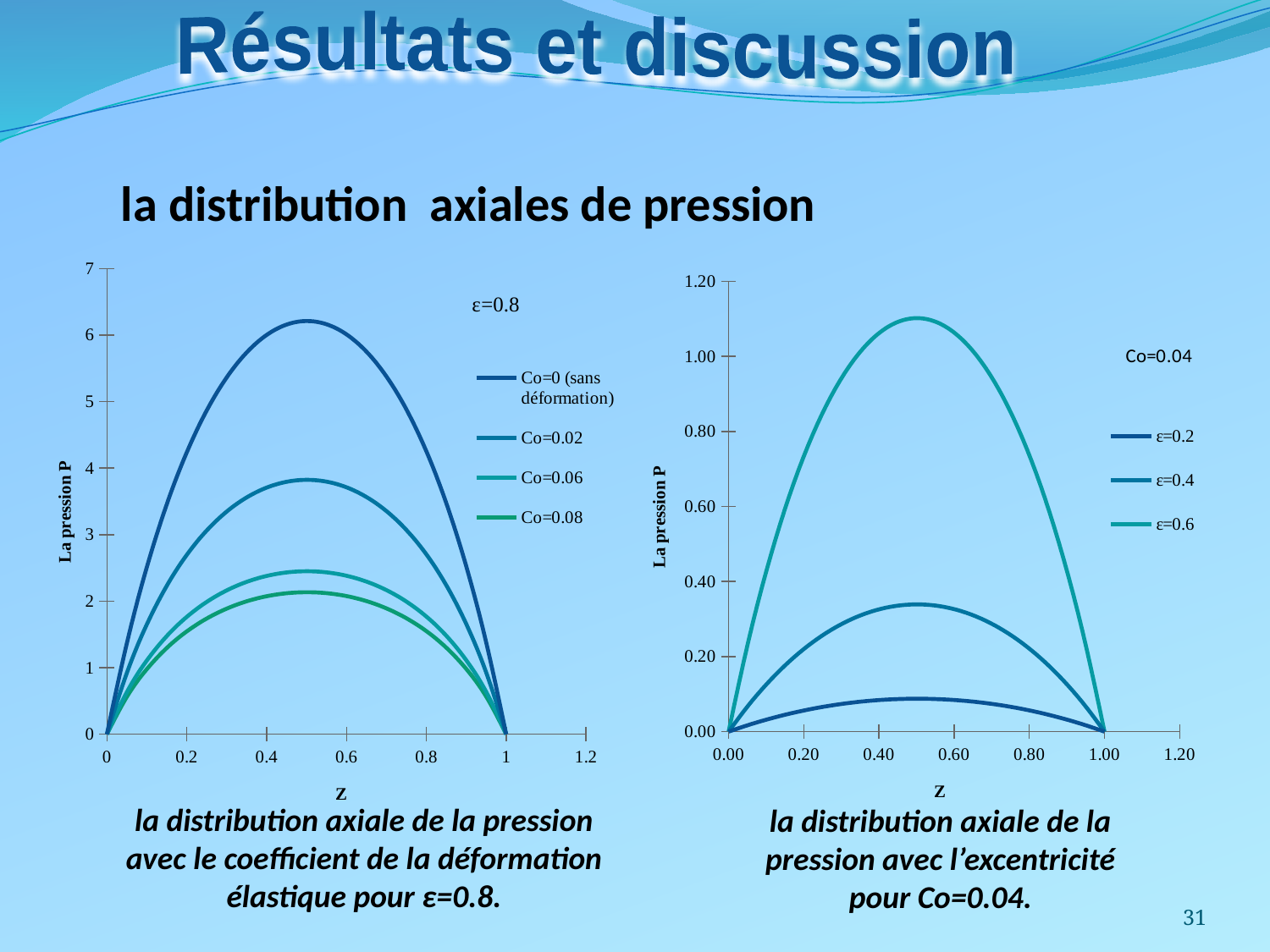
In the right chart (Co=0.04), what is the label of the vertical axis? La pression P In the left chart (ε=0.8), which series reaches the highest pressure? Co=0 (sans déformation) In the left chart (ε=0.8), is the peak value of the Co=0.02 curve greater or less than 4? less In the left chart (ε=0.8), what kind of chart is shown? line chart In the right chart (Co=0.04), which series reaches the lowest peak pressure? ε=0.2 In the right chart (Co=0.04), which series reaches the highest pressure? ε=0.6 In the right chart (Co=0.04), is the peak value of the ε=0.2 curve greater or less than 0.20? less In the left chart (ε=0.8), is the peak value of the Co=0 curve greater or less than 6? greater In the right chart (Co=0.04), how many series does the legend list? 3 In the left chart (ε=0.8), which series reaches the lowest peak pressure? Co=0.08 In the left chart (ε=0.8), how many series does the legend list? 4